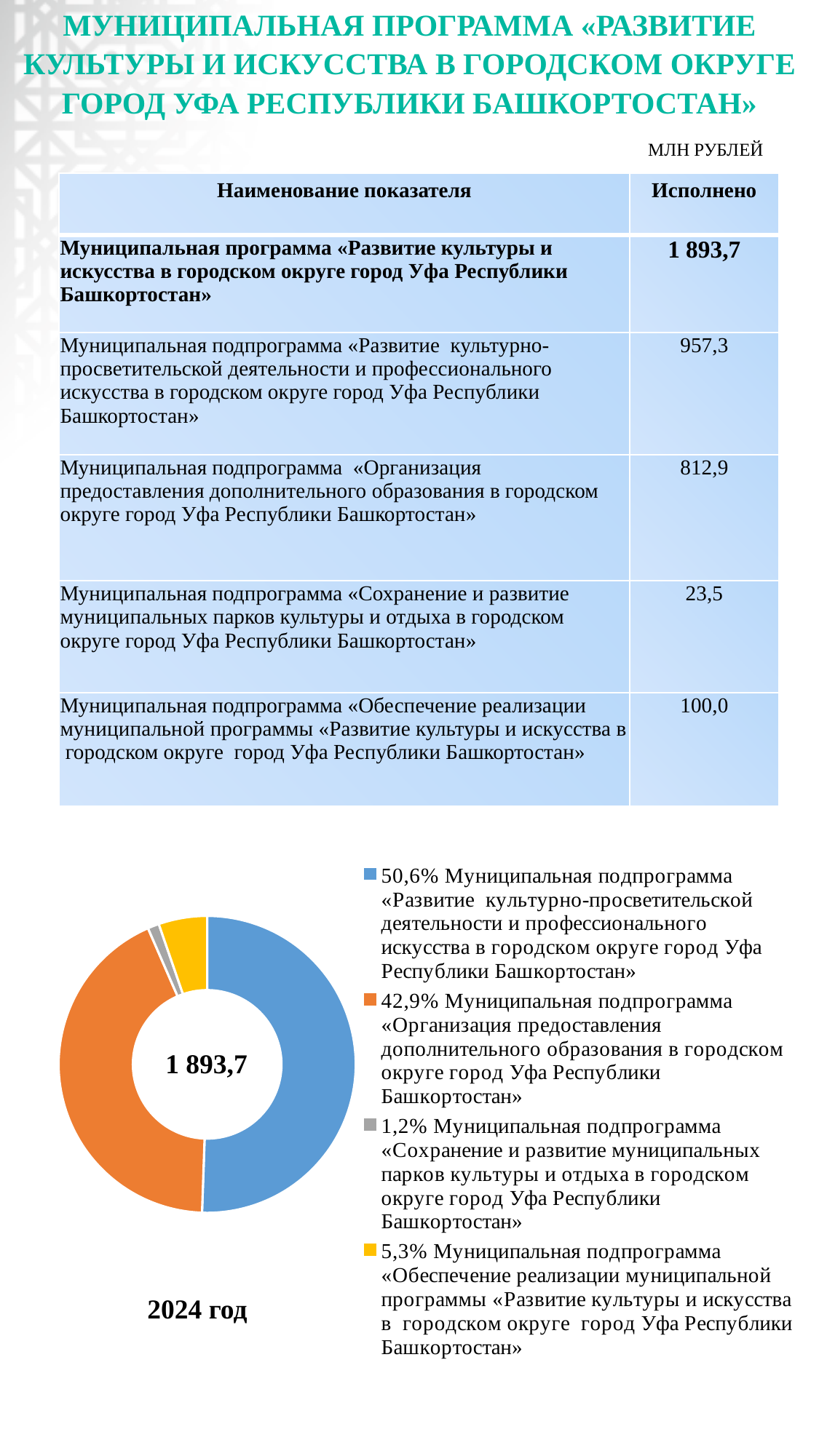
How many entries does the legend of the doughnut chart list? 4 What share of the doughnut chart does the subprogram «Сохранение и развитие муниципальных парков культуры и отдыха в городском округе город Уфа Республики Башкортостан» have? 1,2% What share of the doughnut chart does the subprogram «Развитие культурно-просветительской деятельности и профессионального искусства в городском округе город Уфа Республики Башкортостан» have? 50,6% What share of the doughnut chart does the subprogram «Обеспечение реализации муниципальной программы «Развитие культуры и искусства в городском округе город Уфа Республики Башкортостан» have? 5,3% How many slices does the doughnut chart have? 4 In the doughnut chart, which is larger: the share of the subprogram «Обеспечение реализации муниципальной программы...» or the share of the subprogram «Сохранение и развитие муниципальных парков культуры и отдыха...»? «Обеспечение реализации муниципальной программы...» (5,3%) Which subprogram has the smallest slice in the doughnut chart? Муниципальная подпрограмма «Сохранение и развитие муниципальных парков культуры и отдыха в городском округе город Уфа Республики Башкортостан» What kind of chart is shown at the bottom of the slide? Doughnut (pie) chart What is the difference in percentage points between the two largest slices of the doughnut chart (50,6% and 42,9%)? 7,7 percentage points Which subprogram has the largest slice in the doughnut chart? Муниципальная подпрограмма «Развитие культурно-просветительской деятельности и профессионального искусства в городском округе город Уфа Республики Башкортостан» What value is printed in the centre of the doughnut chart? 1 893,7